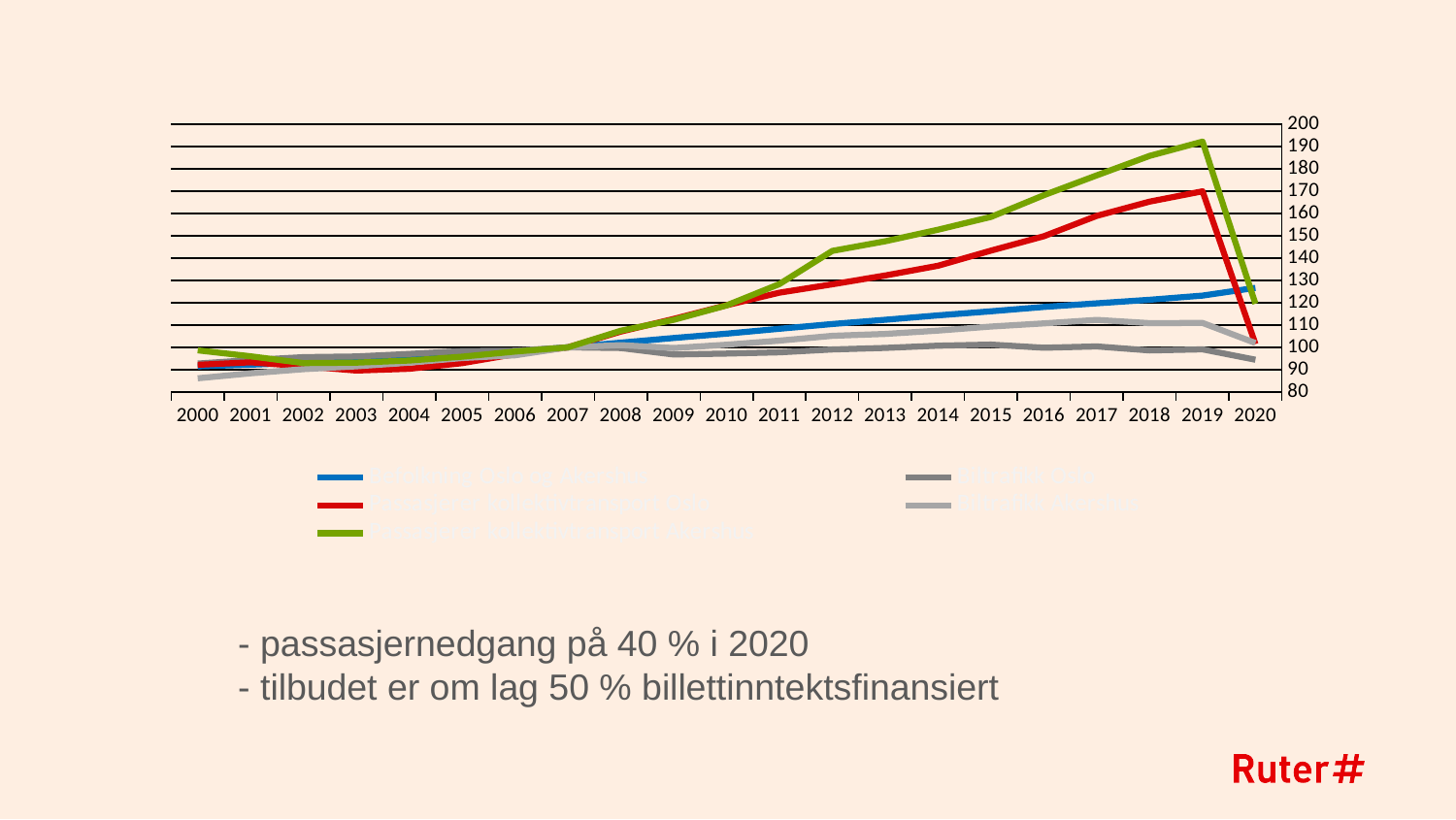
In which year does the green line reach its highest value? 2019 What kind of chart is shown on the slide? line chart In which year does the red line reach its highest value? 2019 Is the value of the blue line in 2020 greater or less than 120? greater Is the value of the green line in 2019 greater or less than 180? greater How many series does the chart's legend list? 5 Does the green line rise or fall between 2019 and 2020? fall Which line has the higher value in 2019, the green line or the blue line? the green line Is the value of the red line in 2019 greater or less than 160? greater What is the first year shown on the x axis of the chart? 2000 How many years are shown along the x axis of the chart? 21 What is the last year shown on the x axis of the chart? 2020